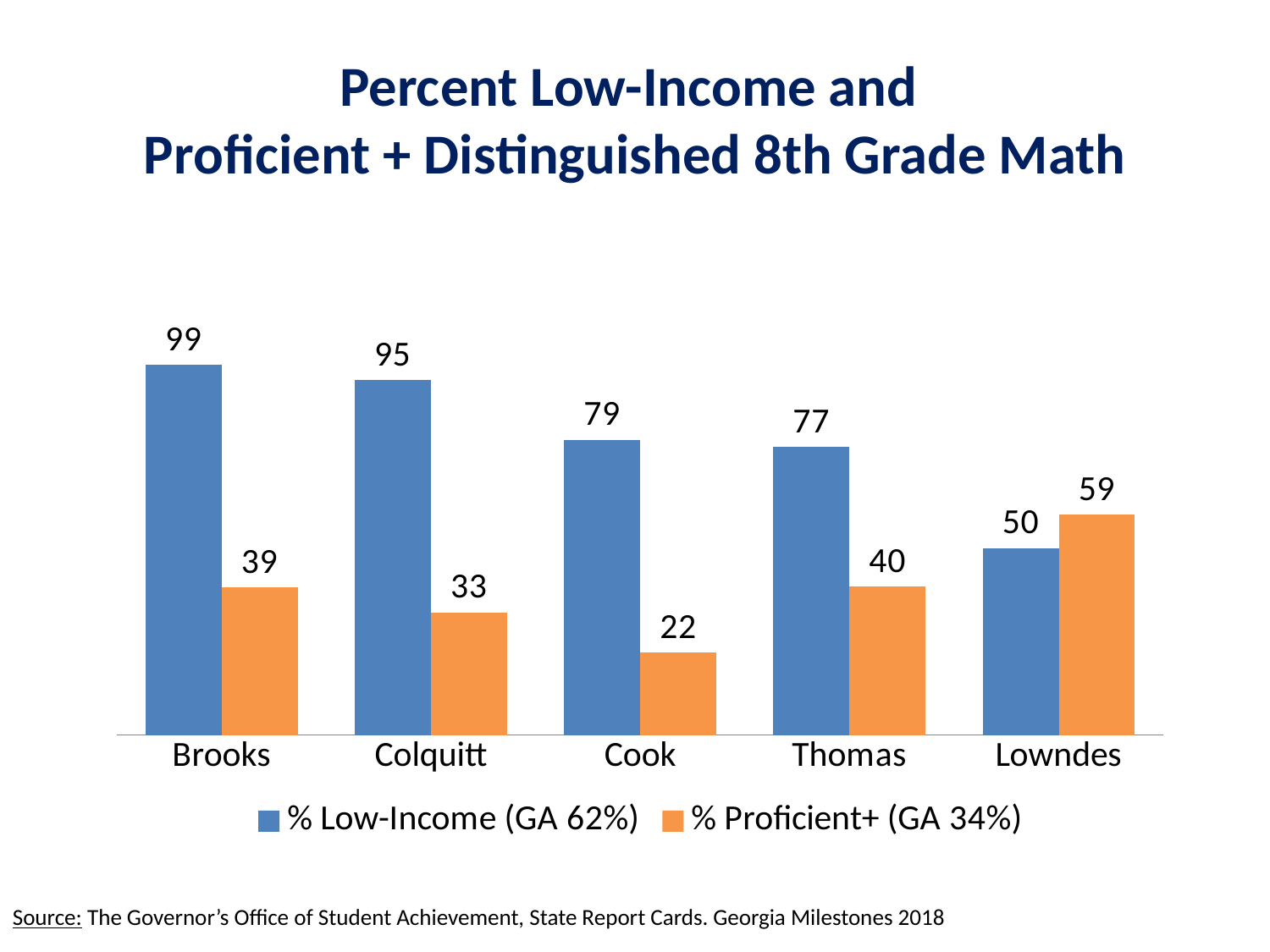
What is the % Low-Income value for Brooks? 99 Which county has the lowest % Proficient+ value? Cook What is the % Proficient+ value for Lowndes? 59 How many counties are shown on the x axis? 5 Which county has the highest % Low-Income value? Brooks What kind of chart is shown on the slide? Bar chart Which county has a higher % Proficient+ value, Brooks or Thomas? Thomas How many series does the legend list? 2 Which is larger for Lowndes: the % Low-Income value or the % Proficient+ value? % Proficient+ What is the % Proficient+ value for Cook? 22 What is the Georgia statewide % Proficient+ value given in the legend? 34% What is the difference between the % Low-Income and % Proficient+ values for Colquitt? 62